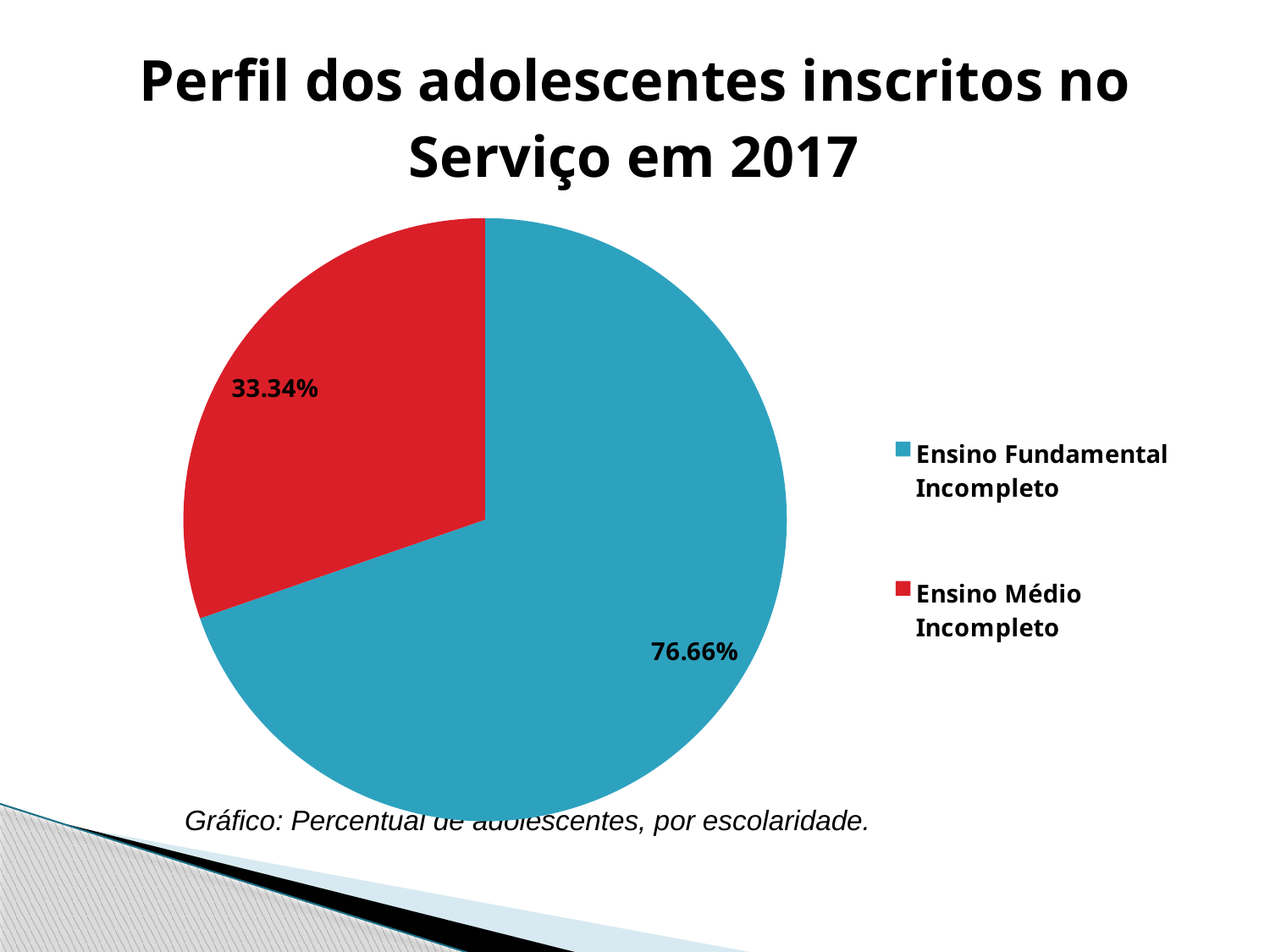
How many slices does the pie chart have? 2 What percentage is shown for Ensino Médio Incompleto? 33.34% What is the caption written below the pie chart? Gráfico: Percentual de adolescentes, por escolaridade. Which is larger, the slice for Ensino Fundamental Incompleto or the slice for Ensino Médio Incompleto? Ensino Fundamental Incompleto What is the difference between the percentage labels for Ensino Fundamental Incompleto and Ensino Médio Incompleto? 43.32% What percentage is shown for Ensino Fundamental Incompleto? 76.66% What share of the pie is labelled for the red slice? 33.34% Which category has the smallest slice of the pie? Ensino Médio Incompleto How many entries does the legend list? 2 Which category has the largest slice of the pie? Ensino Fundamental Incompleto What type of chart is shown on the slide? pie chart What colour is the slice for Ensino Fundamental Incompleto? blue